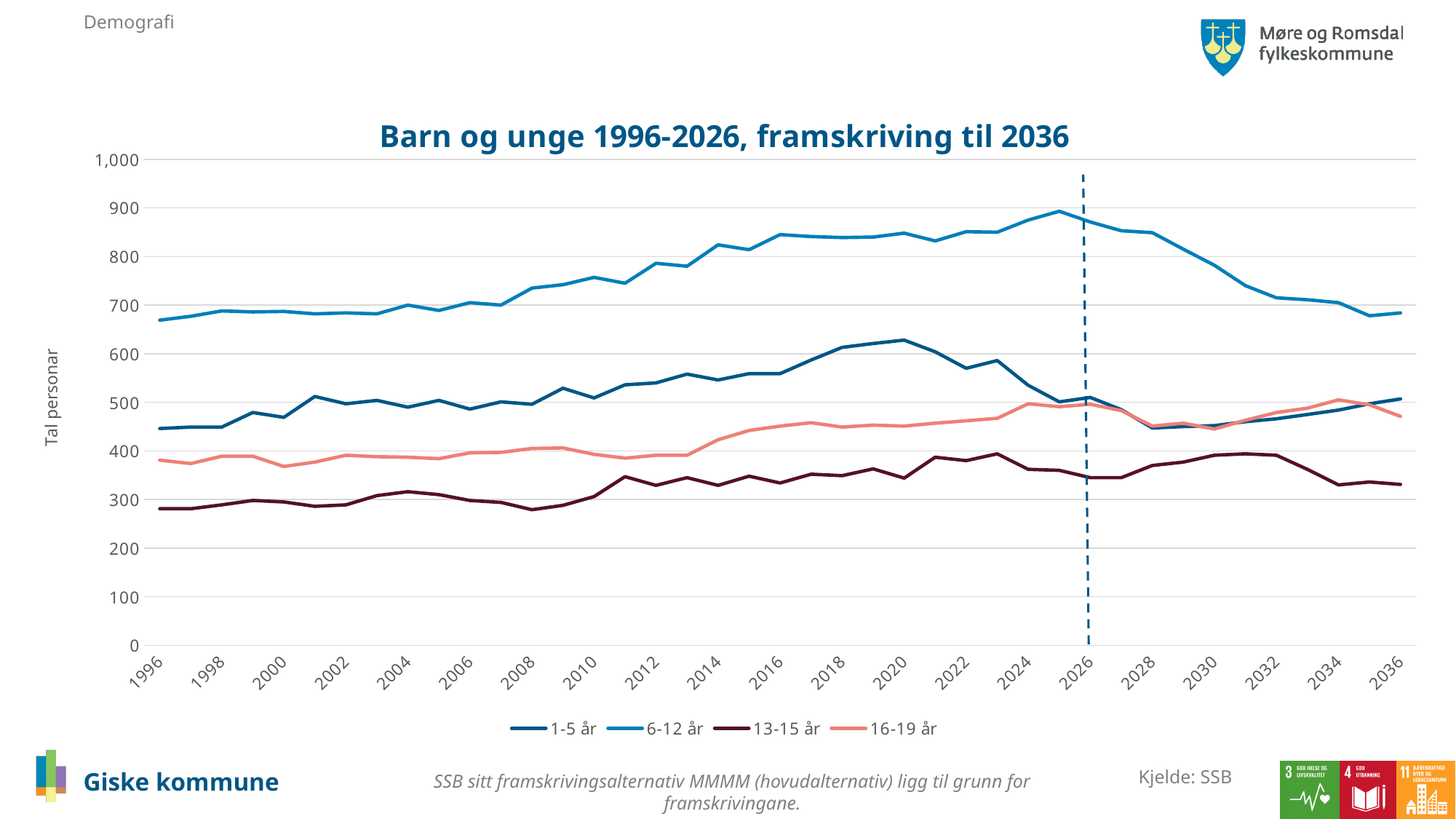
Is the value for 13-15 år in 1996 greater or less than 300? less What is the label on the vertical axis? Tal personar Which series has the lowest values across the whole period? 13-15 år Is the value for 6-12 år in 2025 greater or less than 800? greater How many series does the legend list? 4 Is the value for 6-12 år in 1996 greater or less than 700? less What kind of chart is shown on the slide? line chart Does the 6-12 år series rise or fall between 2026 and 2036? fall Which series has the highest values across the whole period? 6-12 år In 2036, which is larger: the value for 6-12 år or the value for 1-5 år? 6-12 år What is the title of the chart? Barn og unge 1996-2026, framskriving til 2036